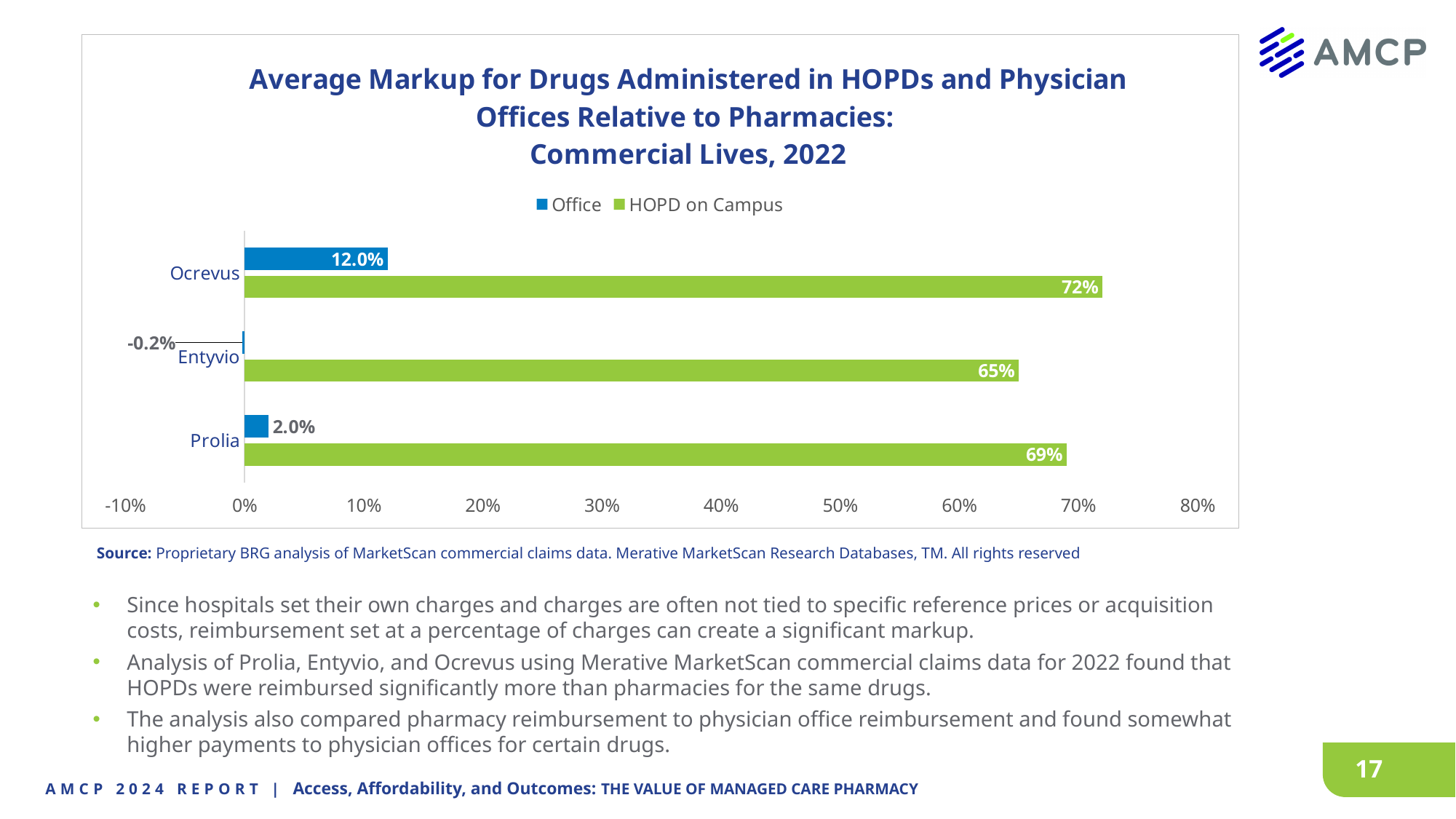
What is the difference between the HOPD on Campus markup and the Office markup for Ocrevus? 60 percentage points What is the HOPD on Campus markup for Ocrevus? 72% Which drug has the lowest Office markup? Entyvio What is the HOPD on Campus markup for Entyvio? 65% Which is larger for Prolia, the Office markup or the HOPD on Campus markup? HOPD on Campus Which drug has the highest HOPD on Campus markup? Ocrevus How many series does the legend list? 2 What is the Office markup for Prolia? 2.0% How many drugs are shown on the chart? 3 Which colour represents the HOPD on Campus series? Green What type of chart is shown on the slide? Bar chart What is the Office markup for Entyvio? -0.2%